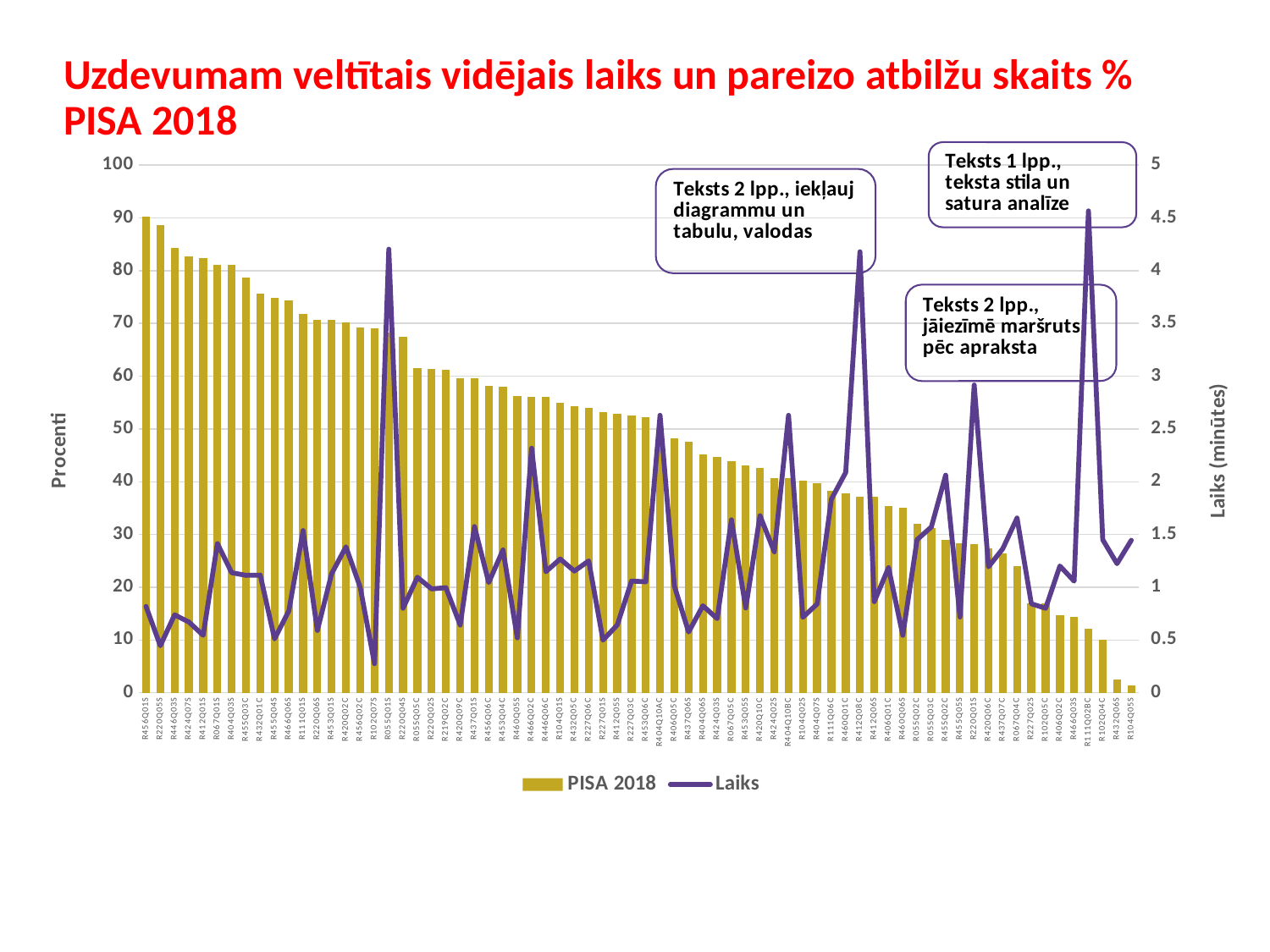
Which is larger, the PISA 2018 bar for R456Q01S or the PISA 2018 bar for R104Q05S? R456Q01S Is the PISA 2018 value for R104Q05S greater or less than 10? less What kind of chart is shown on the slide? A combined bar and line chart How many series does the legend list? 2 Which category has the highest PISA 2018 bar? R456Q01S Do the PISA 2018 bar values rise or fall from left to right along the x axis? Fall What are the two series named in the legend? PISA 2018 and Laiks Is the PISA 2018 value for R456Q01S greater or less than 80? greater Which category has the lowest PISA 2018 bar? R104Q05S What is the title of the chart? Uzdevumam veltītais vidējais laiks un pareizo atbilžu skaits % PISA 2018 Is the highest value of the Laiks line greater or less than 4 minutes? greater What is the maximum value shown on the right-hand (Laiks) axis? 5